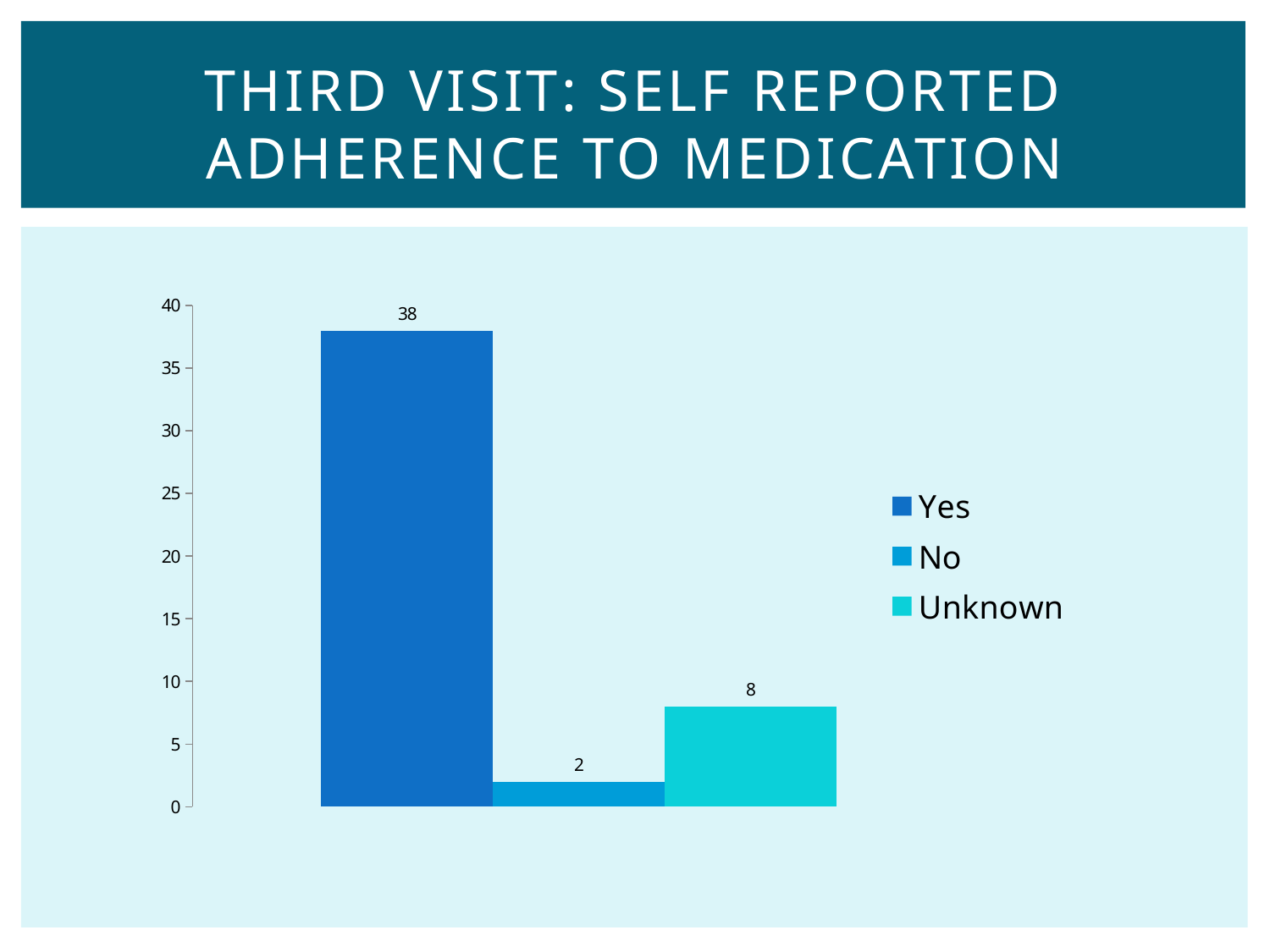
What is the difference between the values for Yes and Unknown? 30 What is the difference between the values for Unknown and No? 6 Which category has the highest value? Yes What is the title of the slide containing the chart? Third Visit: Self Reported Adherence to Medication What is the value for No? 2 Which category has the lowest value? No Is the value for Yes greater or less than 35? greater How many series does the legend list? 3 What is the value for Unknown? 8 Which is larger, the value for Unknown or the value for No? Unknown What kind of chart is shown on the slide? Bar chart What is the value for Yes? 38